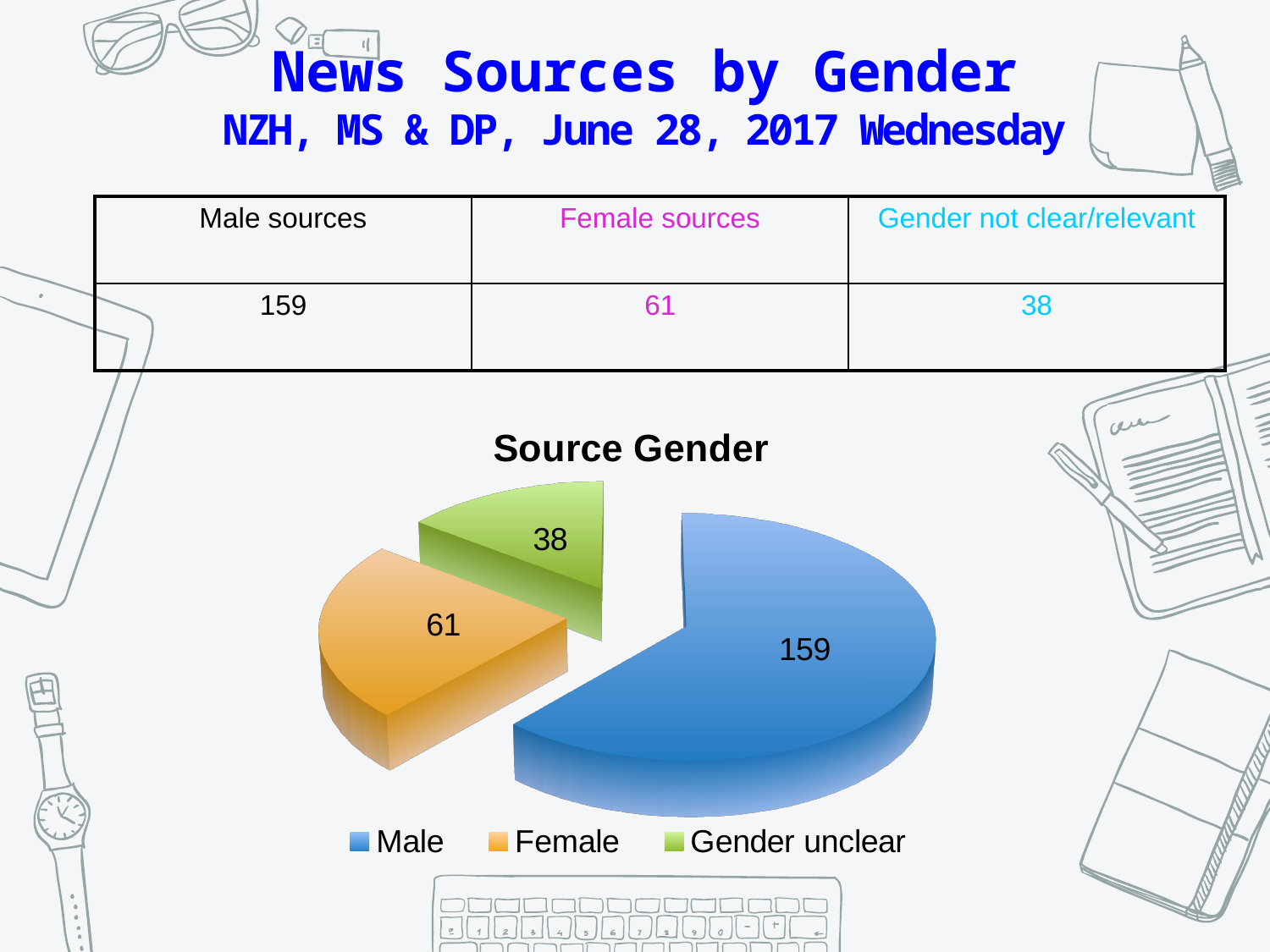
What is the value for Male in the Source Gender pie chart? 159 What is the difference between the Male and Female values in the pie chart? 98 Which category has the smallest slice in the Source Gender pie chart? Gender unclear What colour is the Male slice in the pie chart? blue Which is larger in the pie chart, Female or Gender unclear? Female What is the value for Gender unclear in the Source Gender pie chart? 38 Which category has the largest slice in the Source Gender pie chart? Male What is the title of the chart? Source Gender How many slices does the Source Gender pie chart have? 3 What is the value for Female in the Source Gender pie chart? 61 What is the difference between the Female and Gender unclear values in the pie chart? 23 What type of chart is shown on the slide? pie chart